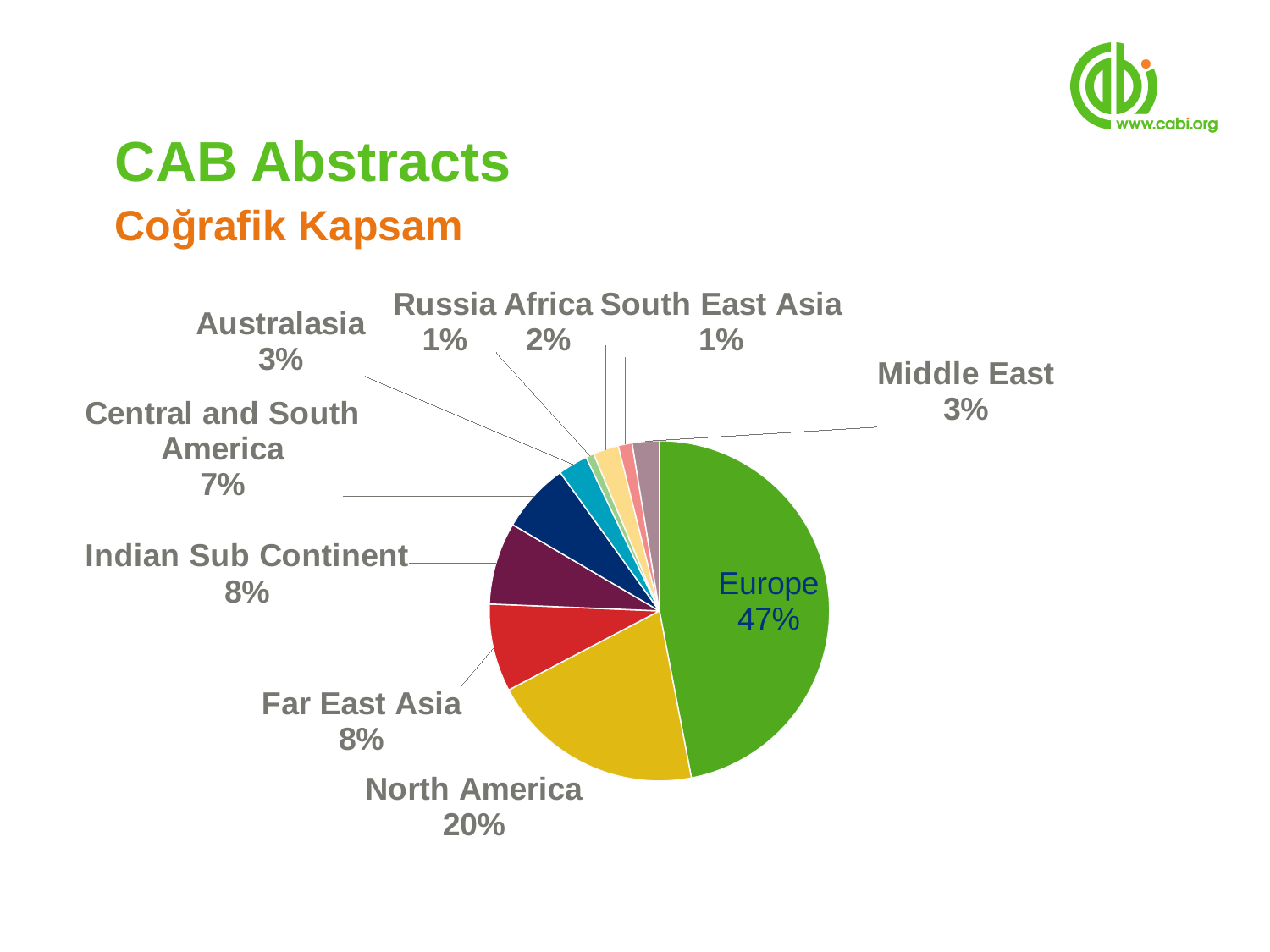
What is the difference between the Middle East and Russia shares? 2% What is the value shown for North America? 20% What is the value shown for Africa? 2% What is the difference between the Europe and North America shares? 27% Which is larger, the share for Far East Asia or the share for Australasia? Far East Asia What type of chart is shown on the slide? pie chart How many regions are shown in the pie chart? 10 What is the subtitle written in orange above the chart? Coğrafik Kapsam What is the value shown for Central and South America? 7% What is the value shown for Indian Sub Continent? 8% Which region has the largest slice of the pie? Europe What share of the pie does Europe represent? 47%